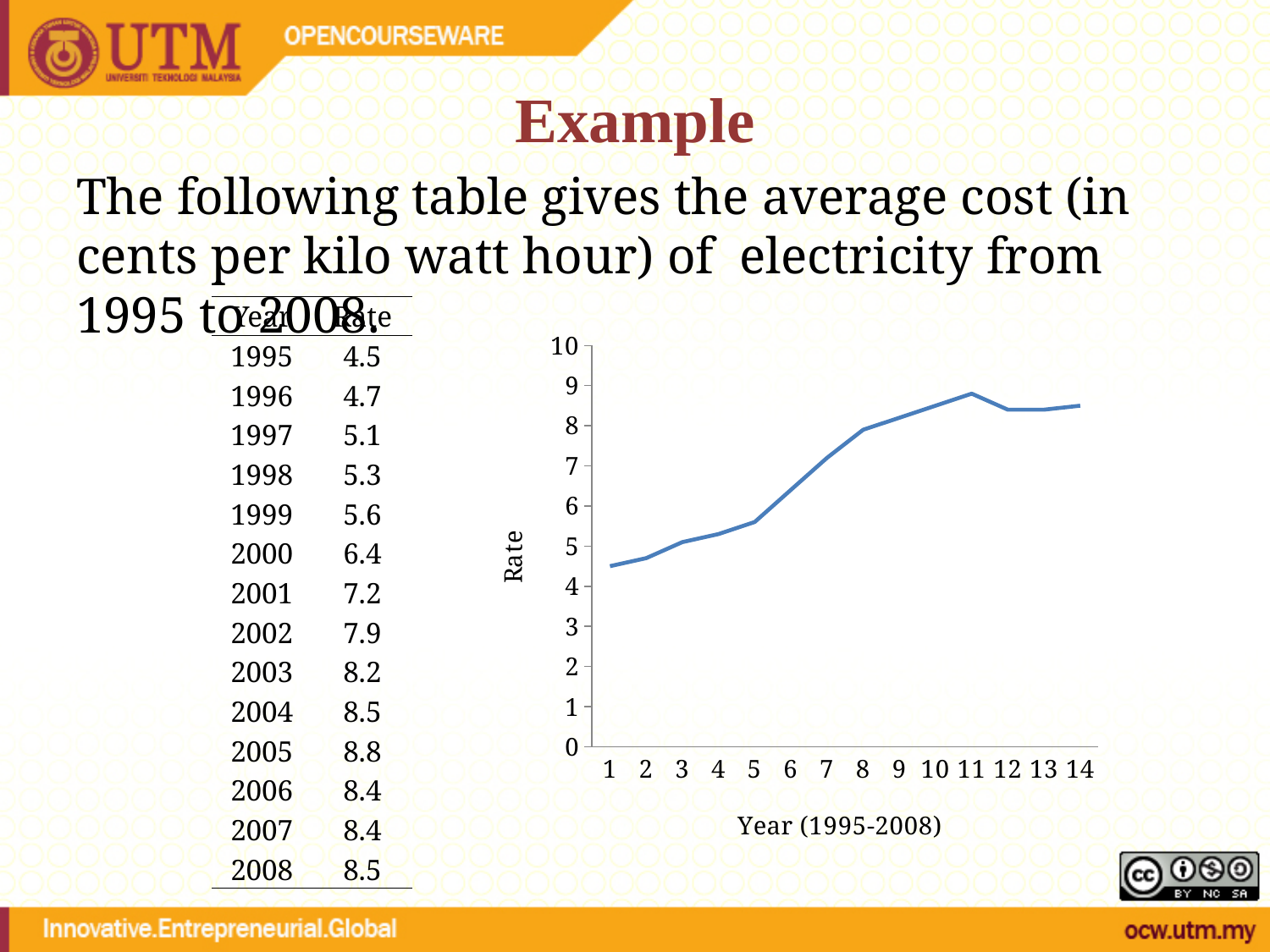
Is the value at x = 3 on the line chart greater or less than 6? less What is the title of the horizontal axis of the line chart? Year (1995-2008) At which x-axis position does the line chart reach its highest value? 11 What kind of chart is shown on the slide? line chart What is the title of the vertical axis of the line chart? Rate At which x-axis position does the line chart have its lowest value? 1 Is the value at x = 8 on the line chart greater or less than 7? greater On the line chart, which is larger: the value at x = 11 or the value at x = 12? x = 11 Do the values on the line chart generally rise or fall from x = 1 to x = 14? rise Is the value at x = 5 on the line chart greater or less than 6? less How many data points are plotted on the line chart? 14 According to the table plotted in the chart, what is the rate for 2005, the highest point on the line? 8.8